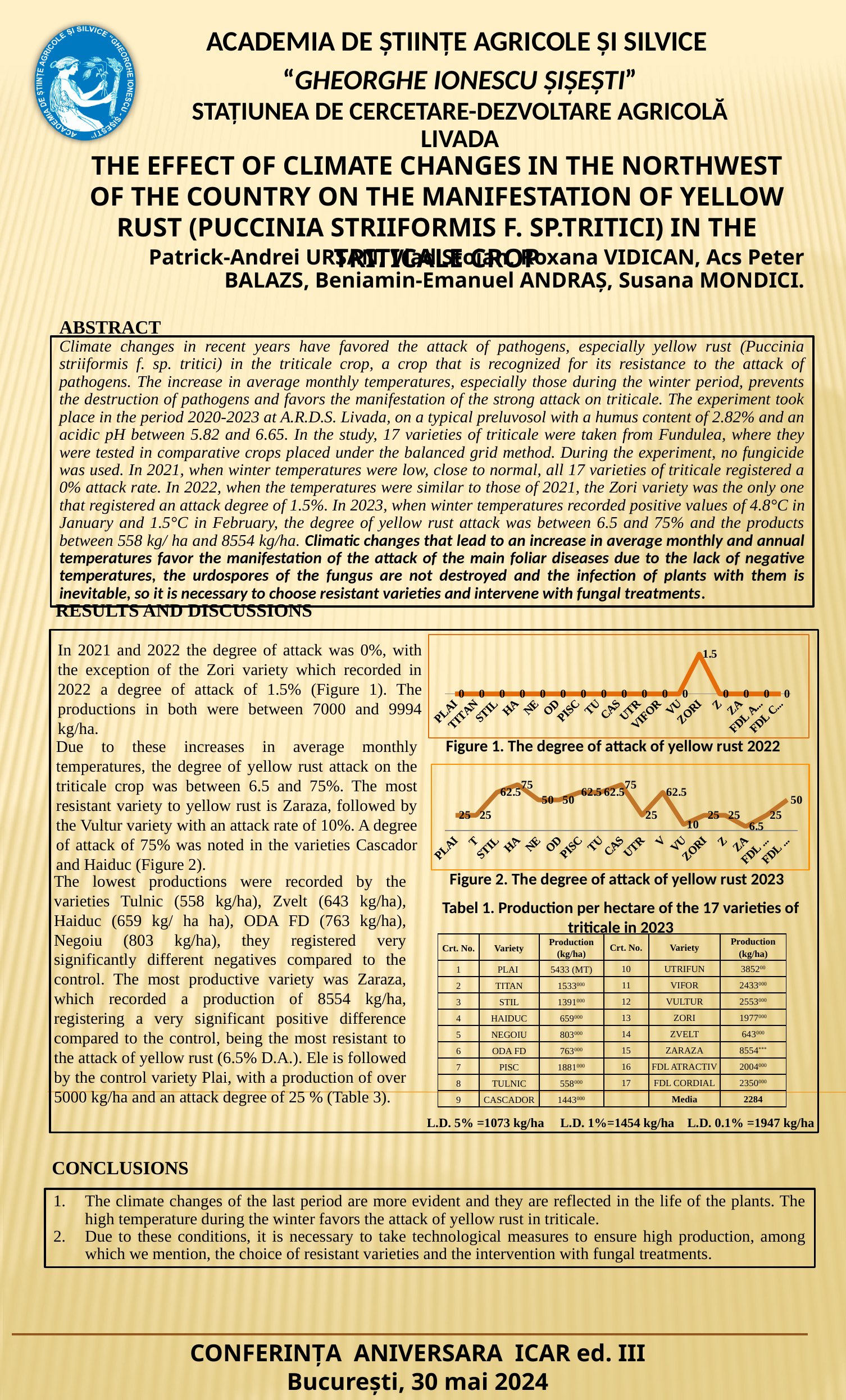
In Figure 1 (The degree of attack of yellow rust 2022), which category has the highest value? ZORI In Figure 2 (The degree of attack of yellow rust 2023), which category has the lowest value? ZA In Figure 1 (The degree of attack of yellow rust 2022), what value is shown for PLAI? 0 How many categories are plotted in Figure 2 (The degree of attack of yellow rust 2023)? 17 In Figure 2 (The degree of attack of yellow rust 2023), which has the larger value, STIL or NE? STIL What kind of chart is Figure 2 (The degree of attack of yellow rust 2023)? line chart In Figure 1 (The degree of attack of yellow rust 2022), what value is shown for ZORI? 1.5 In Figure 2 (The degree of attack of yellow rust 2023), what is the difference between the values for HA and PLAI? 50 In Figure 2 (The degree of attack of yellow rust 2023), what value is shown for ZA? 6.5 In Figure 2 (The degree of attack of yellow rust 2023), what value is shown for HA? 75 What kind of chart is Figure 1 (The degree of attack of yellow rust 2022)? line chart In Figure 2 (The degree of attack of yellow rust 2023), what value is shown for VU? 10